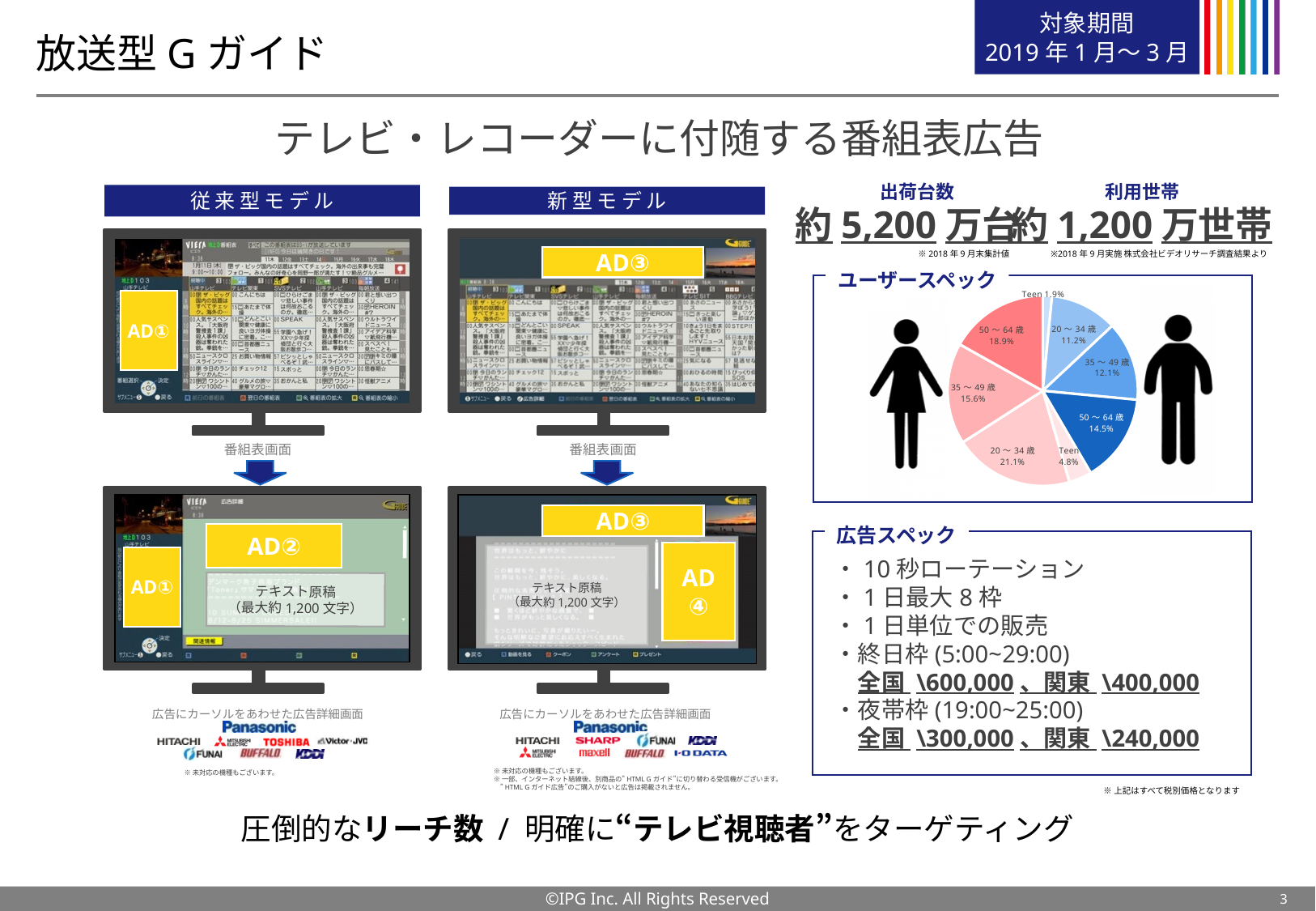
What is the title of the box containing the pie chart? ユーザースペック In the ユーザースペック pie chart, what is the share of the pink (female-side) 20～34歳 slice? 21.1% In the ユーザースペック pie chart, which is larger: the blue 35～49歳 slice or the blue 20～34歳 slice? the blue 35～49歳 slice (12.1%) In the ユーザースペック pie chart, what is the difference between the pink 50～64歳 slice (18.9%) and the blue 50～64歳 slice (14.5%)? 4.4% In the ユーザースペック pie chart, what is the share of the pink (female-side) 35～49歳 slice? 15.6% In the ユーザースペック pie chart, what is the difference between the pink Teen slice (4.8%) and the blue Teen slice (1.9%)? 2.9% In the ユーザースペック pie chart, what is the share of the blue (male-side) Teen slice? 1.9% What kind of chart is shown in the ユーザースペック section? pie chart In the ユーザースペック pie chart, which slice has the largest share? 20～34歳 (pink, female side), 21.1% In the ユーザースペック pie chart, how many slices are there? 8 In the ユーザースペック pie chart, which slice has the smallest share? Teen (blue, male side), 1.9% In the ユーザースペック pie chart, what is the share of the blue (male-side) 50～64歳 slice? 14.5%